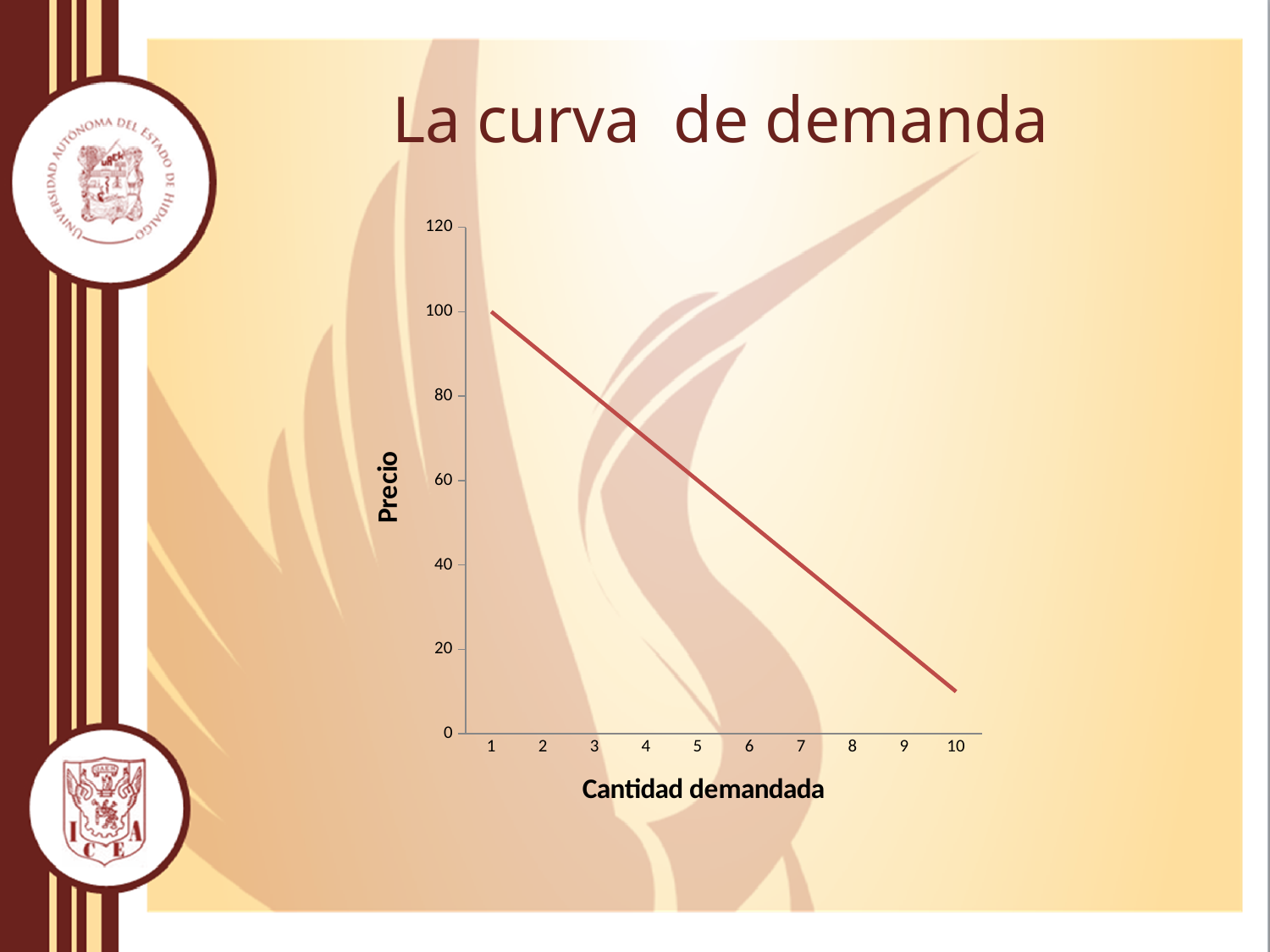
What is the Precio value when Cantidad demandada is 1? 100 Do the values rise or fall as Cantidad demandada increases from 1 to 10? fall Which has a higher Precio: Cantidad demandada 2 or Cantidad demandada 8? 2 At which Cantidad demandada is Precio highest? 1 What kind of chart is shown on the slide? line chart Is the Precio value at Cantidad demandada 10 greater or less than 20? less What is the label of the vertical axis? Precio At which Cantidad demandada is Precio lowest? 10 Is the Precio value at Cantidad demandada 8 greater or less than 40? less What is the title of the chart on the slide? La curva de demanda How many points on the x axis (Cantidad demandada) does the chart show? 10 Is the Precio value at Cantidad demandada 2 greater or less than 80? greater